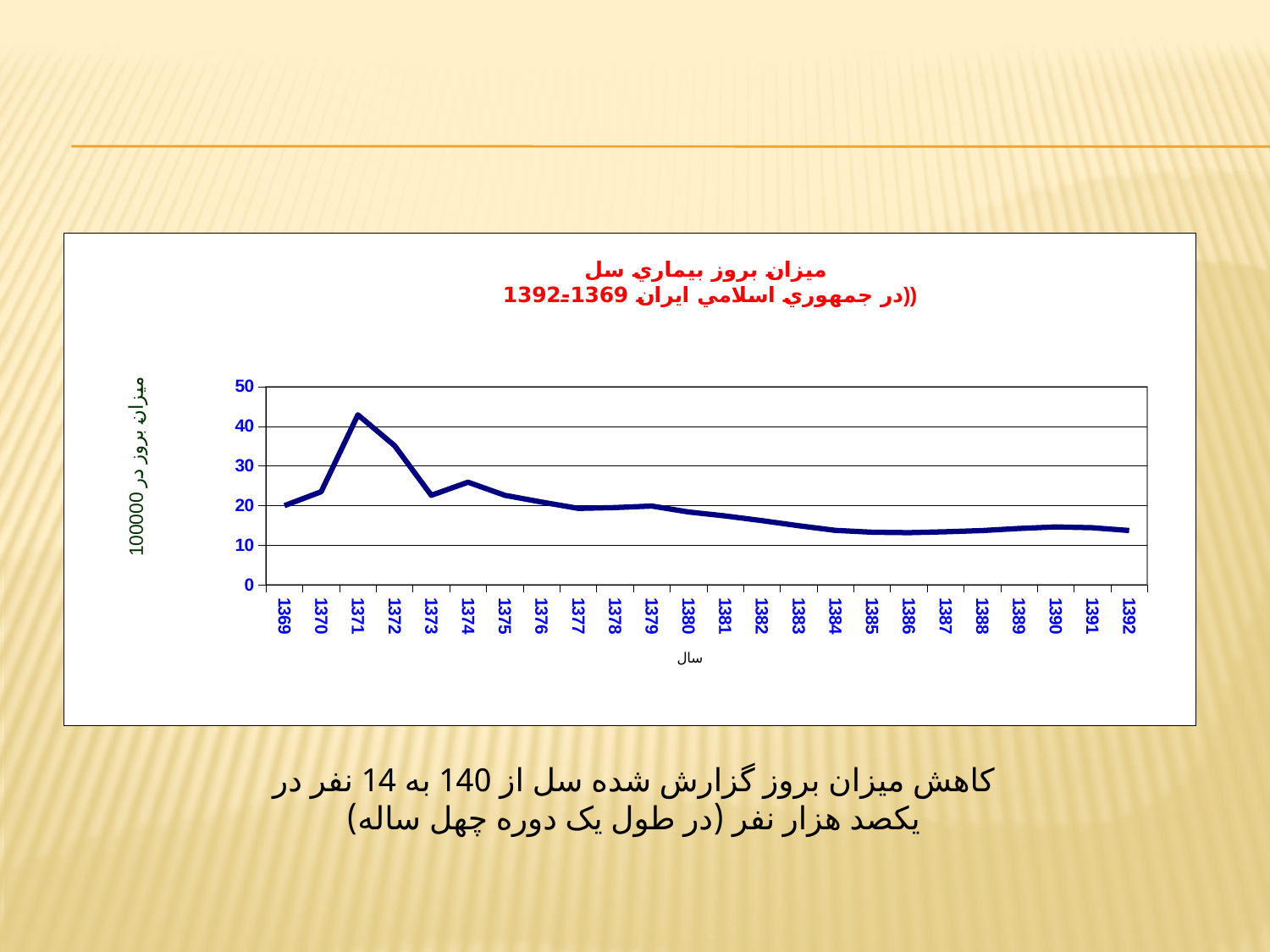
Is the value for 1384 greater or less than 20? less Is the value for 1392 greater or less than 20? less Is the value for 1374 greater or less than 20? greater How many years are plotted along the x axis of the chart? 24 Overall, do the values rise or fall from 1371 to 1392? fall Which year has the highest incidence rate in the chart? 1371 Which year has the larger value, 1371 or 1373? 1371 What is the label on the x axis of the chart? سال Which year has the larger value, 1372 or 1385? 1372 What kind of chart is shown on the slide? line chart